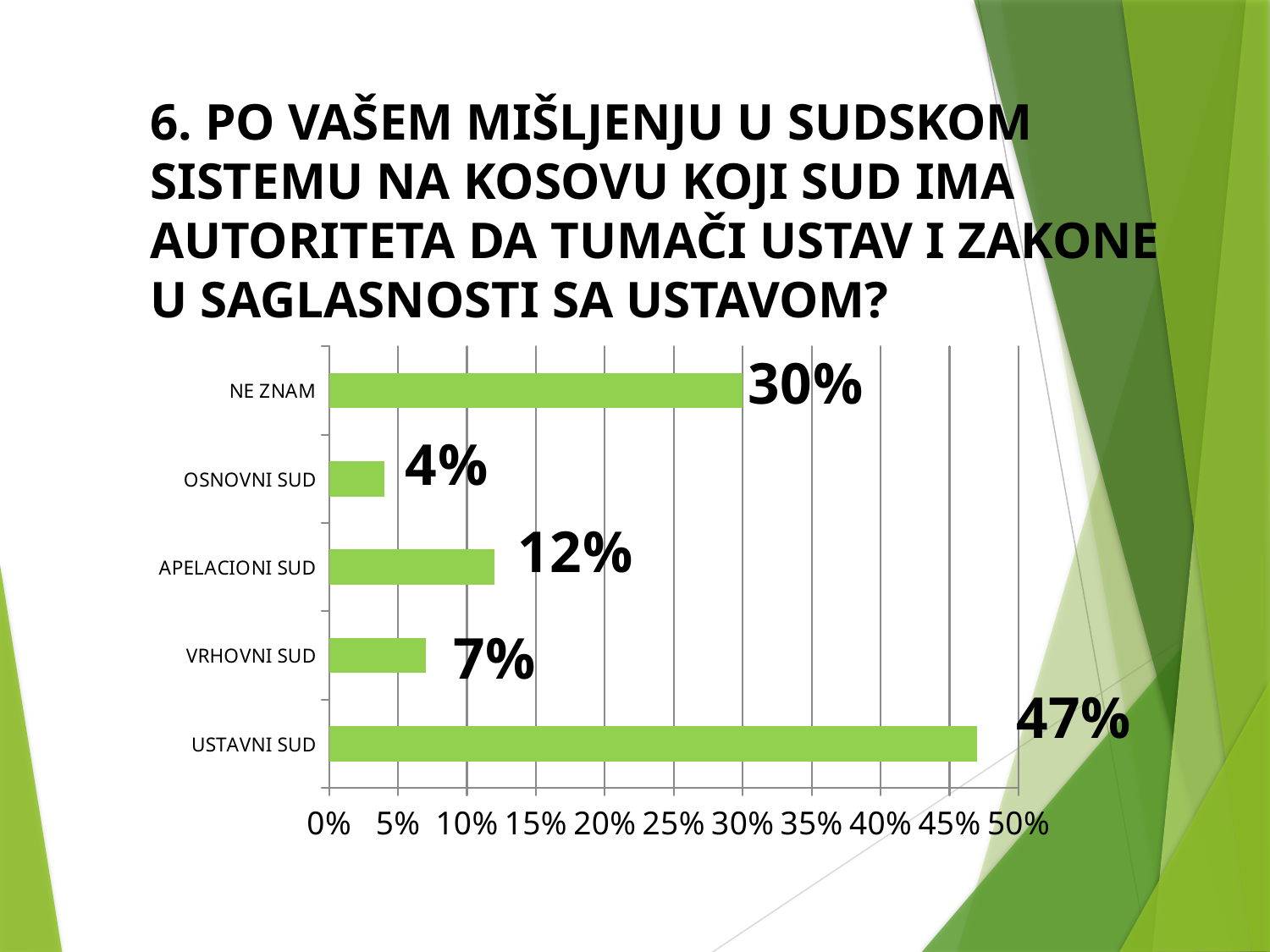
What is the value for NE ZNAM? 30% What is the difference between the values for USTAVNI SUD and NE ZNAM? 17% What is the difference between the values for APELACIONI SUD and OSNOVNI SUD? 8% Is the value for USTAVNI SUD greater or less than 45%? greater What is the value for VRHOVNI SUD? 7% Which category has the lowest value? OSNOVNI SUD How many categories are shown in the chart? 5 Which category has the highest value? USTAVNI SUD What is the value for USTAVNI SUD? 47% What kind of chart is shown on the slide? bar chart Which is larger, the value for APELACIONI SUD or the value for VRHOVNI SUD? APELACIONI SUD What is the value for APELACIONI SUD? 12%